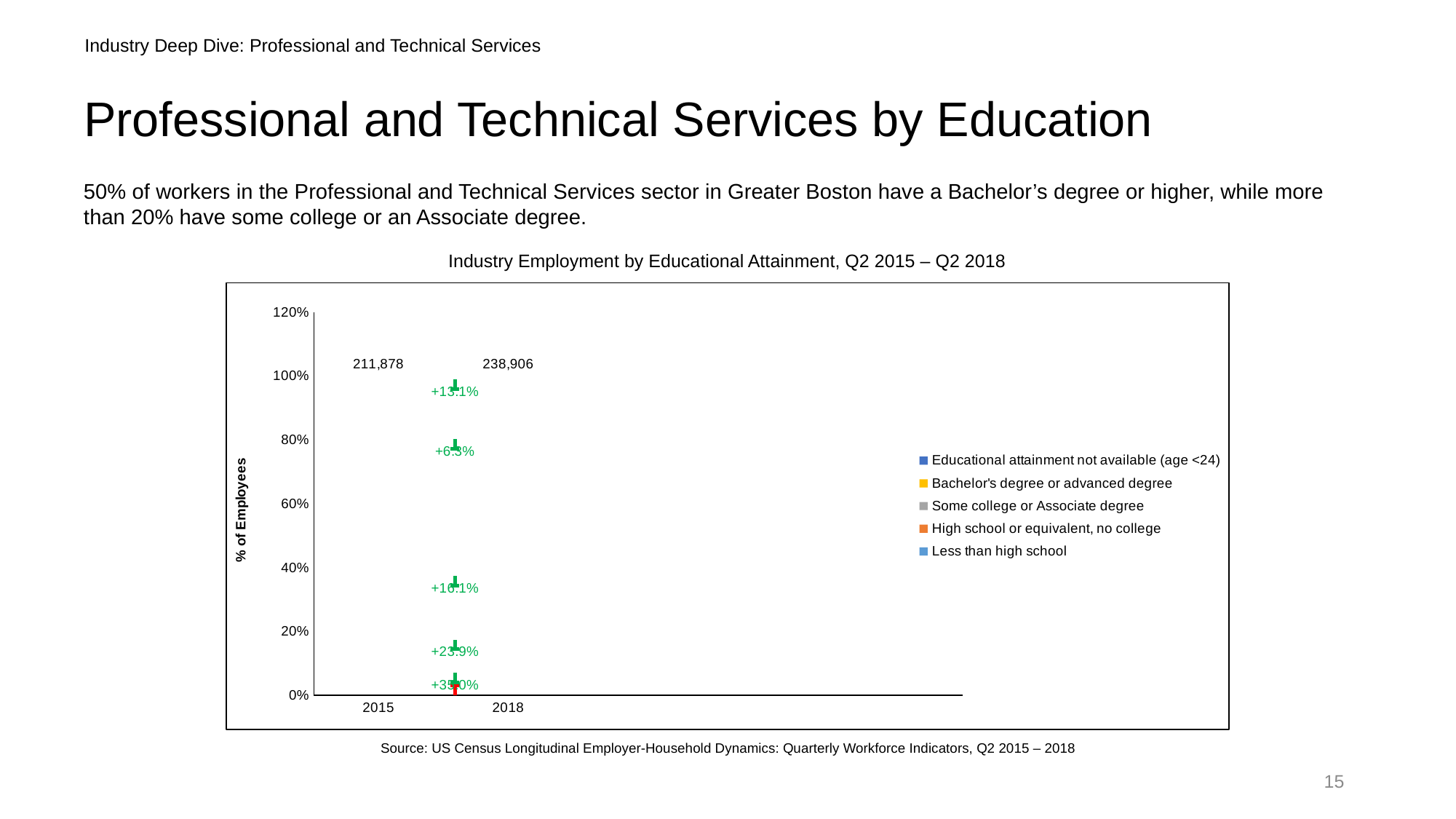
What is the title of the chart? Industry Employment by Educational Attainment, Q2 2015 – Q2 2018 What is the label on the chart's y axis? % of Employees Which year has the larger total employment figure printed above it, 2015 or 2018? 2018 How many years are shown on the x axis of the chart? 2 What total employment figure is printed above the 2018 bar? 238,906 How many series does the chart's legend list? 5 What is the difference between the total employment figures printed for 2018 and 2015? 27,028 What total employment figure is printed above the 2015 bar? 211,878